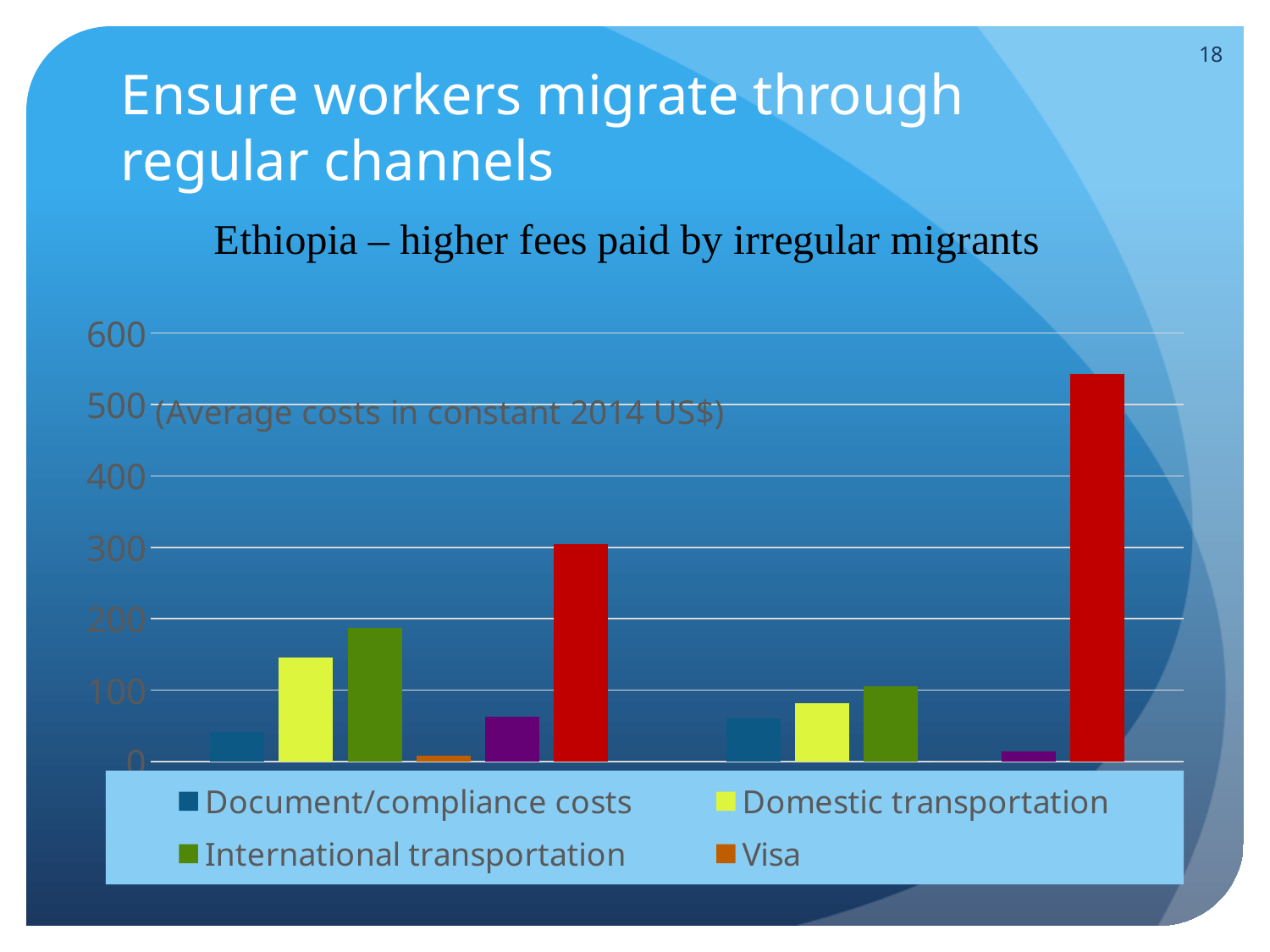
In the left group of bars, which of the legend series has the lowest value? Visa In the left group of bars, which is larger: International transportation or Domestic transportation? International transportation In the left group of bars, is the value for Domestic transportation greater or less than 100? greater What kind of chart is shown on the slide? bar chart In what units are the costs in the chart expressed, according to the note on the chart? constant 2014 US$ In the right group of bars, is the value for Domestic transportation greater or less than 100? less In the left group of bars, is the value for Document/compliance costs greater or less than 100? less What is the title of the chart? (Average costs in constant 2014 US$) How many series does the chart legend list? 4 How many groups of bars are plotted on the chart? 2